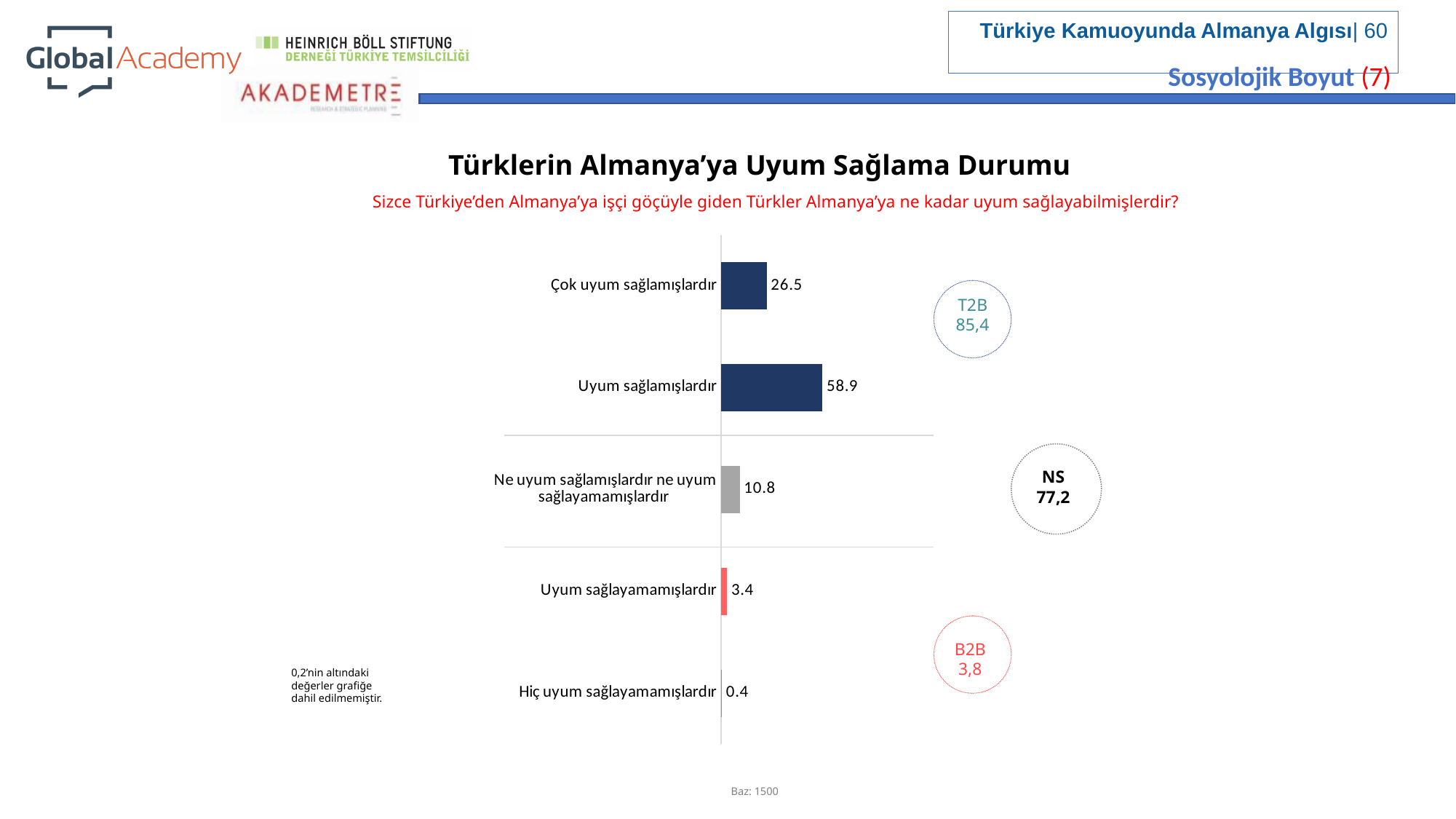
Which category has the highest value? Uyum sağlamışlardır Which category has the lowest value? Hiç uyum sağlayamamışlardır What is the T2B value shown in the circle next to the chart? 85,4 What is the title of the chart? Türklerin Almanya'ya Uyum Sağlama Durumu What kind of chart is shown on the slide? Bar chart What is the difference between the values for "Uyum sağlamışlardır" and "Çok uyum sağlamışlardır"? 32.4 What is the value for "Hiç uyum sağlayamamışlardır"? 0.4 What is the value for "Uyum sağlamışlardır"? 58.9 Which is larger: the value for "Uyum sağlayamamışlardır" or "Ne uyum sağlamışlardır ne uyum sağlayamamışlardır"? Ne uyum sağlamışlardır ne uyum sağlayamamışlardır What is the value for "Çok uyum sağlamışlardır"? 26.5 How many categories are shown in the chart? 5 What is the value for "Ne uyum sağlamışlardır ne uyum sağlayamamışlardır"? 10.8